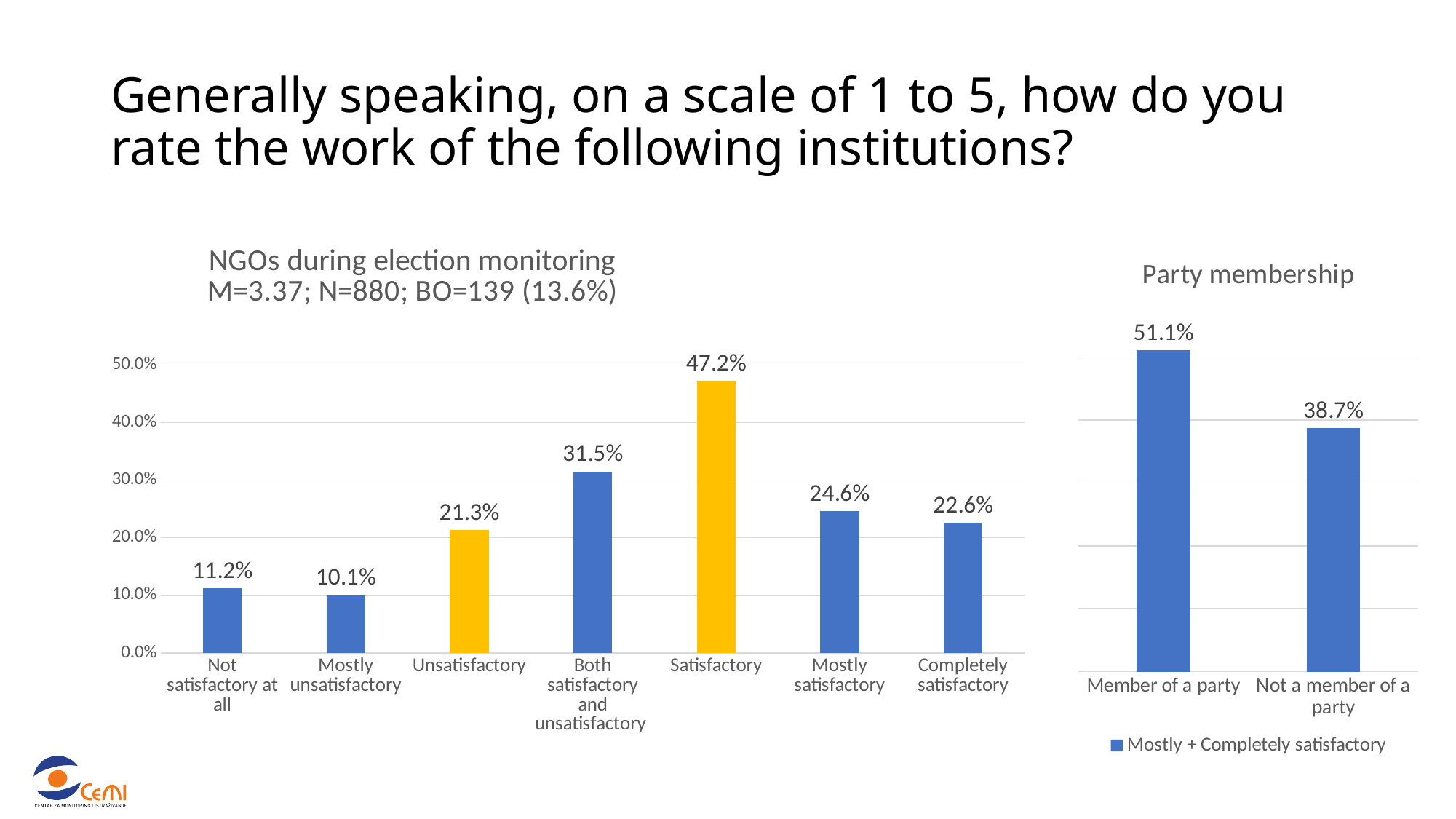
In the 'Party membership' chart, what series does the legend list? Mostly + Completely satisfactory In the 'Party membership' chart, what is the value for Not a member of a party? 38.7% In the 'NGOs during election monitoring' chart, which two categories have bars coloured yellow? Unsatisfactory and Satisfactory In the 'Party membership' chart, what is the difference between Member of a party and Not a member of a party? 12.4% In the 'NGOs during election monitoring' chart, what is the difference between Satisfactory and Both satisfactory and unsatisfactory? 15.7% In the 'NGOs during election monitoring' chart, what is the value for Satisfactory? 47.2% In the 'NGOs during election monitoring' chart, which category has the highest value? Satisfactory What kind of chart is the 'Party membership' chart? Bar chart How many categories are shown in the 'NGOs during election monitoring' chart? 7 In the 'NGOs during election monitoring' chart, which category has the lowest value? Mostly unsatisfactory In the 'NGOs during election monitoring' chart, what is the value for Mostly unsatisfactory? 10.1% In the 'NGOs during election monitoring' chart, which is larger: Mostly satisfactory or Completely satisfactory? Mostly satisfactory